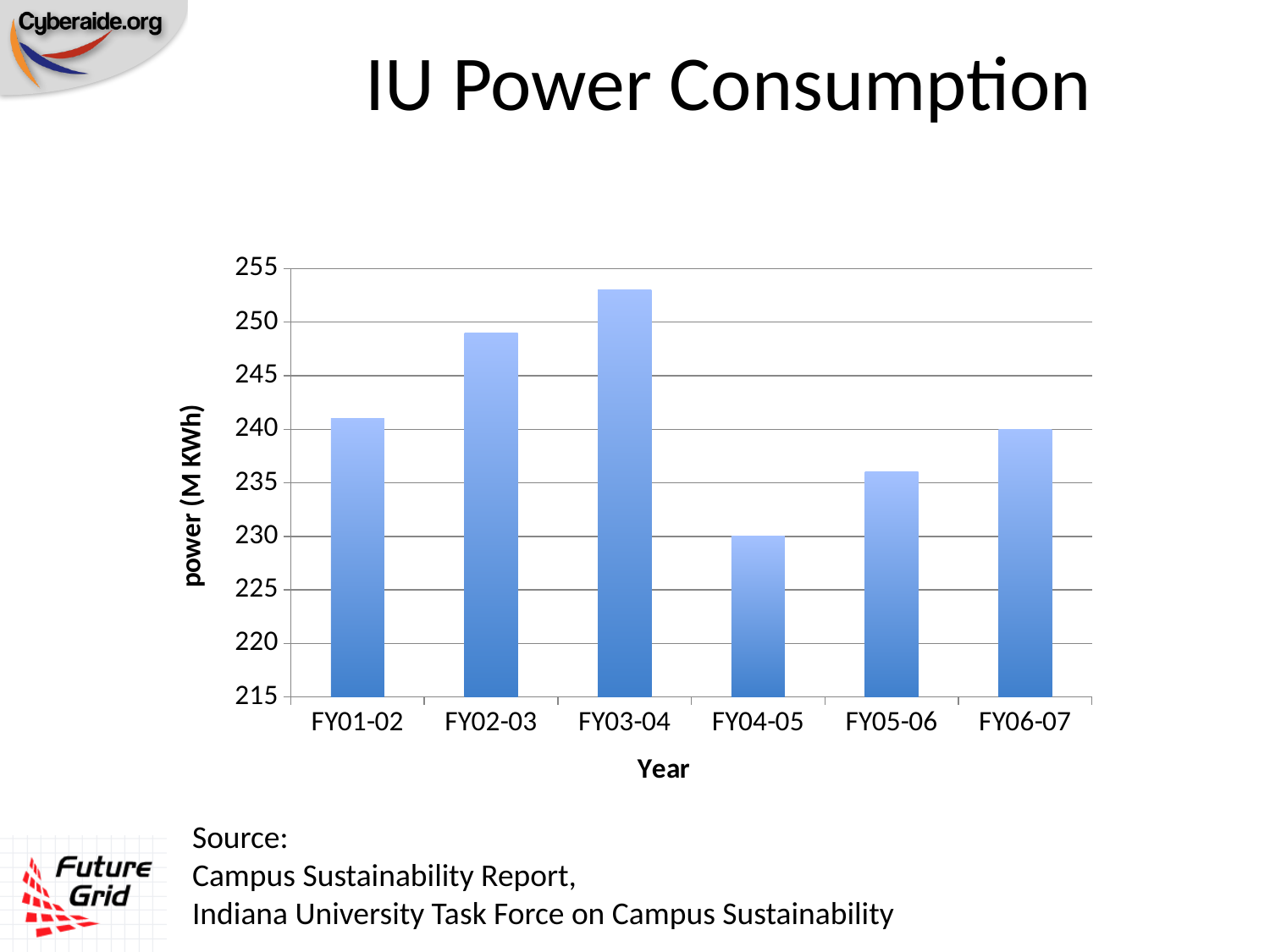
Is the value for FY03-04 greater or less than 250? greater Is the value for FY05-06 greater or less than 240? less Does power consumption rise or fall from FY03-04 to FY04-05? fall Is the value for FY02-03 greater or less than 245? greater Which has higher power consumption, FY01-02 or FY05-06? FY01-02 What is the power consumption for FY06-07? 240 What is the power consumption for FY04-05? 230 What kind of chart is shown on the slide? bar chart How many fiscal years are shown on the x axis of the chart? 6 Which fiscal year has the highest power consumption? FY03-04 Which fiscal year has the lowest power consumption? FY04-05 What is the label of the vertical axis of the chart? power (M KWh)